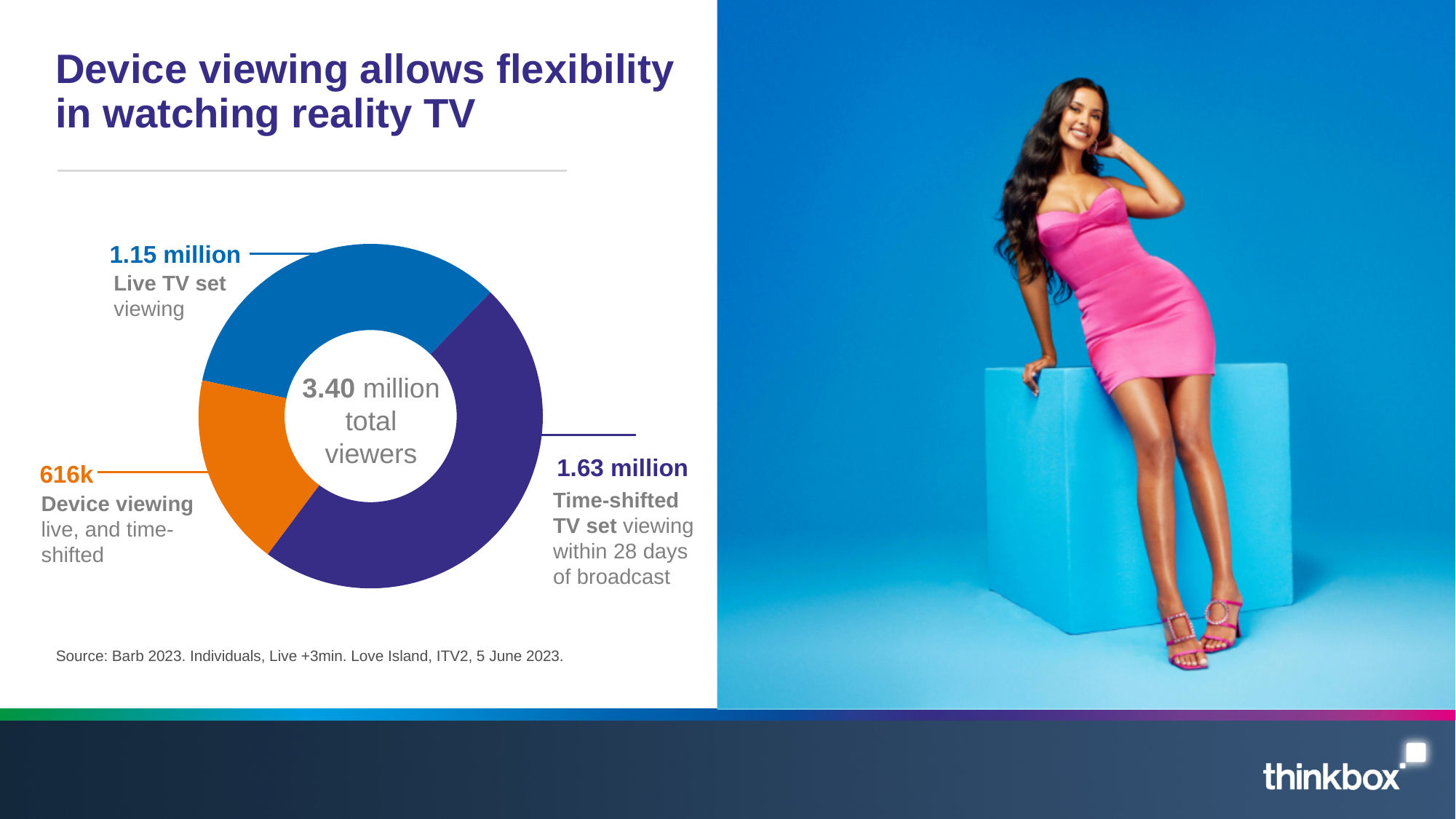
What kind of chart is shown on the slide? Donut (pie) chart Which viewing type has the largest segment in the chart? Time-shifted TV set viewing What colour is the Device viewing segment of the chart? Orange How many viewers does the chart show for Live TV set viewing? 1.15 million How many viewers does the chart show for Time-shifted TV set viewing within 28 days of broadcast? 1.63 million Which is larger: Live TV set viewing or Time-shifted TV set viewing? Time-shifted TV set viewing What is the difference in viewers between Time-shifted TV set viewing and Live TV set viewing? 0.48 million How many segments does the donut chart have? 3 Which viewing type has the smallest segment in the chart? Device viewing How many viewers does the chart show for Device viewing (live and time-shifted)? 616k What is the total number of viewers shown in the centre of the donut chart? 3.40 million What is the title of the slide containing the chart? Device viewing allows flexibility in watching reality TV